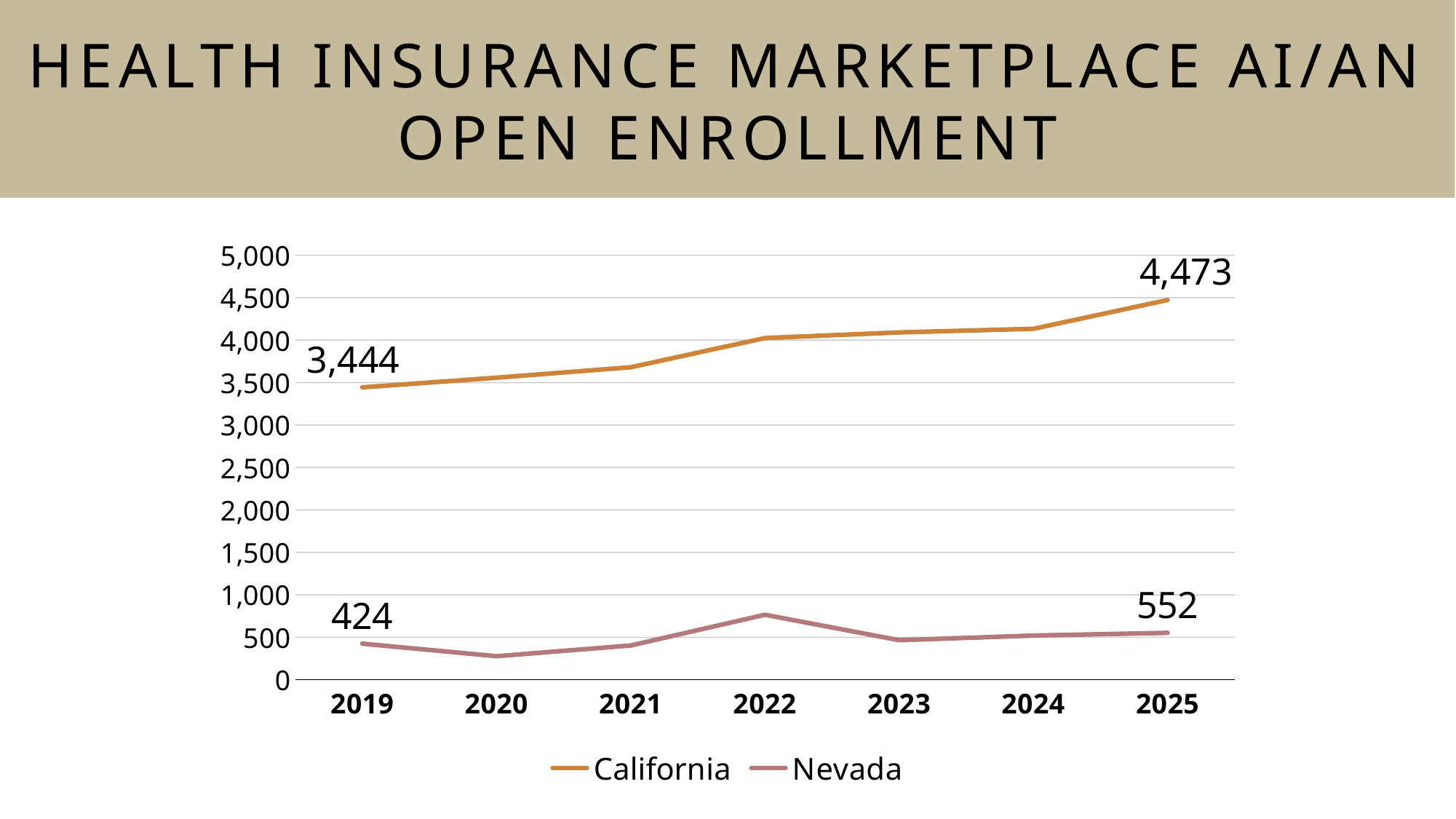
Which series has the higher value in 2025, California or Nevada? California What is the California value for 2025? 4,473 Is the California value for 2021 greater or less than 4,000? less What is the Nevada value for 2019? 424 What is the Nevada value for 2025? 552 By how much did the Nevada value increase from 2019 to 2025? 128 What kind of chart is shown on the slide? Line chart How many series does the legend list? 2 What is the California value for 2019? 3,444 By how much did the California value increase from 2019 to 2025? 1,029 Is the Nevada value for 2022 greater or less than 500? greater How many years are shown on the x axis? 7